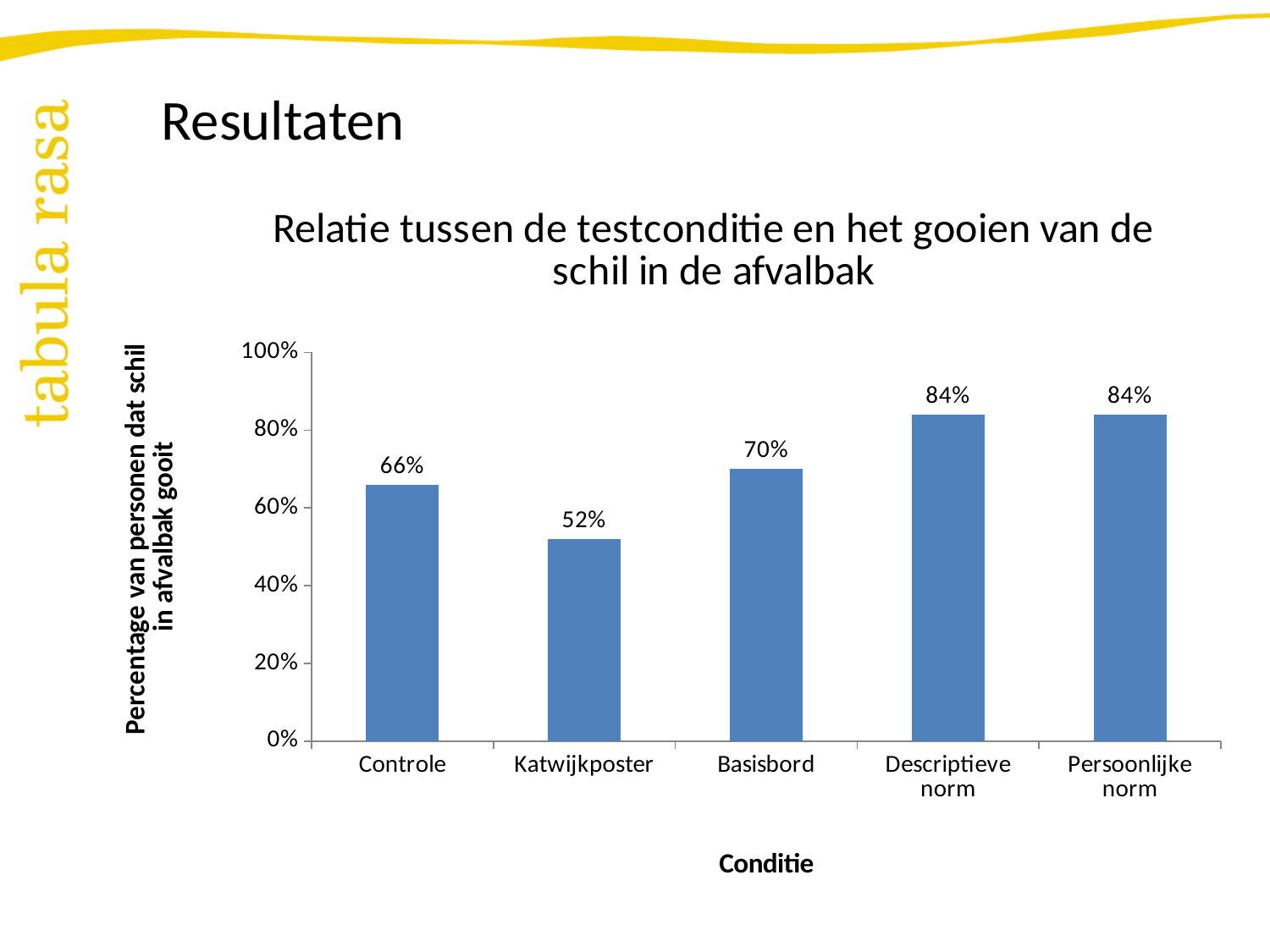
What kind of chart is shown on the slide? bar chart What is the label of the x axis? Conditie What is the value for Basisbord? 70% What is the value for Controle? 66% How many conditions are shown on the x axis? 5 What is the value for Descriptieve norm? 84% Which condition has the lowest value? Katwijkposter What is the value for Katwijkposter? 52% Is the value for Katwijkposter greater or less than 60%? less What is the difference between the values for Basisbord and Katwijkposter? 18% Which is larger, the value for Basisbord or the value for Controle? Basisbord What is the difference between the values for Persoonlijke norm and Controle? 18%